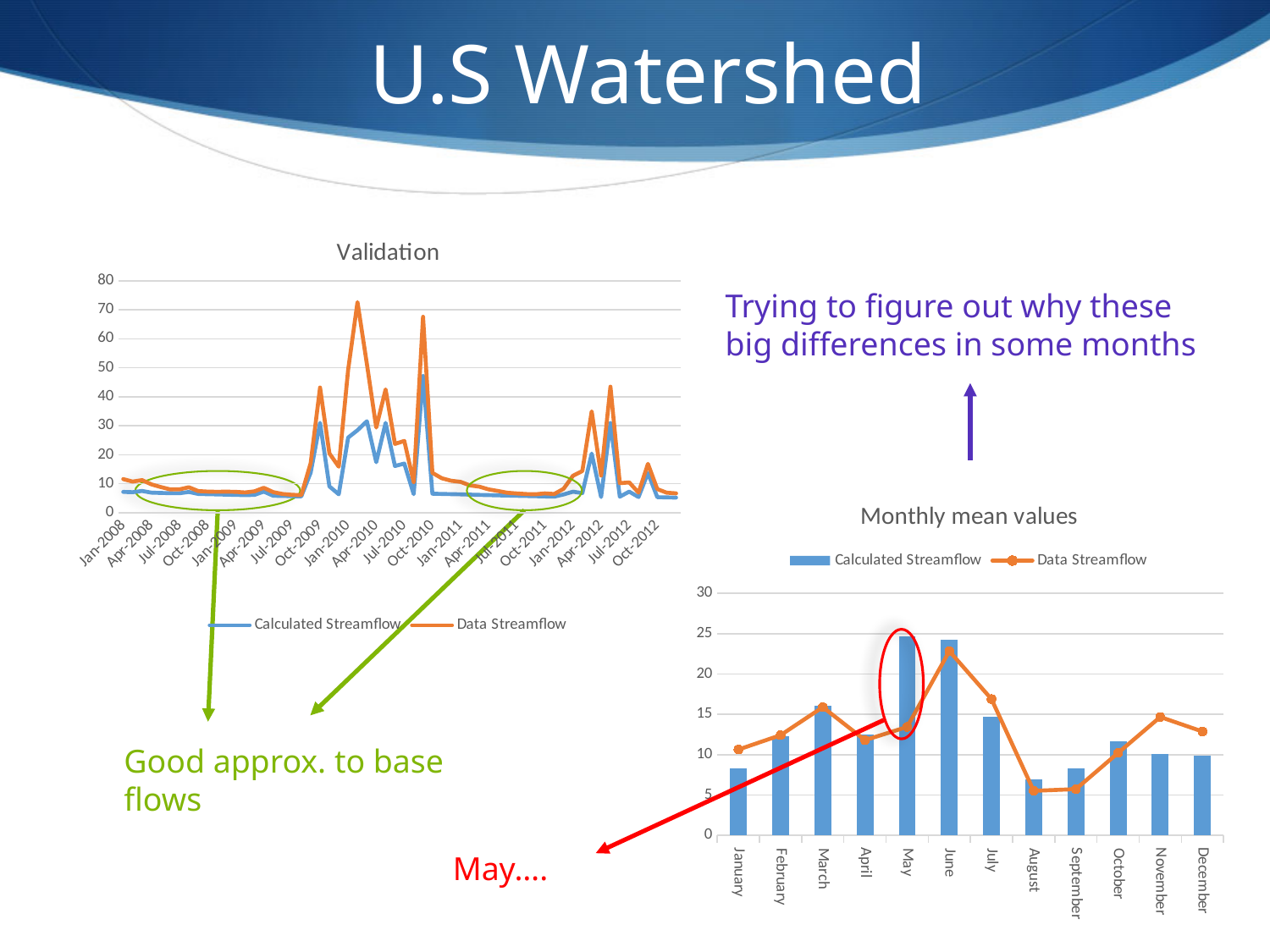
What kind of chart is the 'Validation' chart on the left? line chart What is the title of the chart on the right of the slide? Monthly mean values In the 'Validation' chart, is the Calculated Streamflow value at Jan-2008 greater or less than 20? less In the 'Monthly mean values' chart, is the Data Streamflow value for June greater or less than 20? greater How many series does the legend of the 'Validation' chart list? 2 In the 'Monthly mean values' chart, which is larger for July, Calculated Streamflow or Data Streamflow? Data Streamflow In the 'Validation' chart, is the highest value of Data Streamflow greater or less than 60? greater In the 'Monthly mean values' chart, which is larger for May, Calculated Streamflow or Data Streamflow? Calculated Streamflow How many categories are shown on the x axis of the 'Monthly mean values' chart? 12 In the 'Validation' chart, which series reaches the higher peak, Calculated Streamflow or Data Streamflow? Data Streamflow In the 'Monthly mean values' chart, which series is drawn as bars? Calculated Streamflow